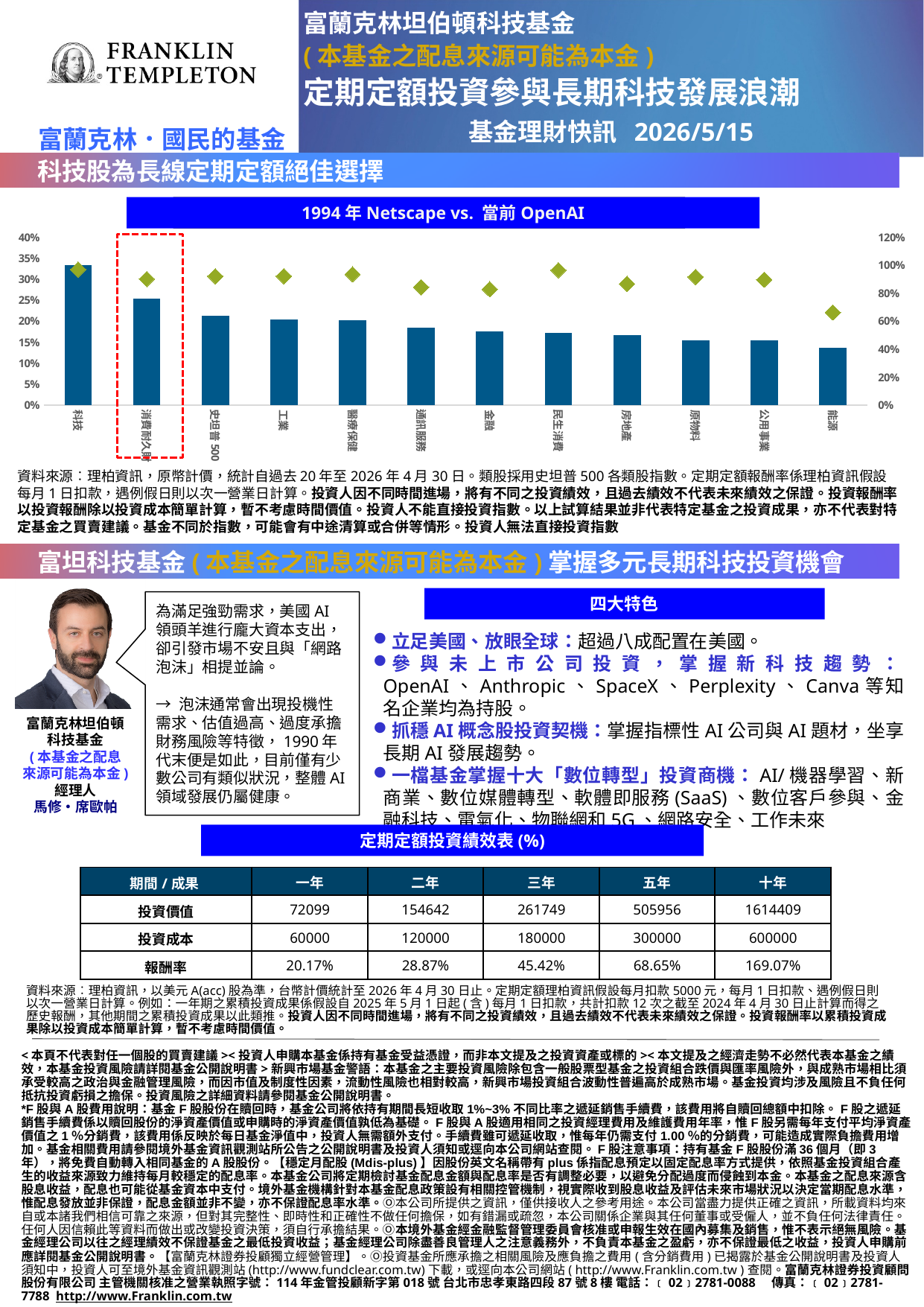
In the '1994 年 Netscape vs. 當前 OpenAI' chart, do the bar heights generally rise or fall from left to right? fall In the '1994 年 Netscape vs. 當前 OpenAI' chart, is the bar for 消費耐久財 greater or less than 20% on the left axis? greater Which category on the '1994 年 Netscape vs. 當前 OpenAI' chart is highlighted with a red dashed box? 消費耐久財 In the '1994 年 Netscape vs. 當前 OpenAI' chart, which category has the lowest diamond marker? 能源 In the '1994 年 Netscape vs. 當前 OpenAI' chart, which category has the tallest bar? 科技 What kind of chart is shown under the title '1994 年 Netscape vs. 當前 OpenAI'? combination bar and line chart (bars with diamond markers) In the '1994 年 Netscape vs. 當前 OpenAI' chart, which bar is taller: 科技 or 能源? 科技 In the '1994 年 Netscape vs. 當前 OpenAI' chart, is the diamond marker for 能源 greater or less than 80% on the right axis? less In the '1994 年 Netscape vs. 當前 OpenAI' chart, which category has the shortest bar? 能源 In the '1994 年 Netscape vs. 當前 OpenAI' chart, is the bar for 科技 greater or less than 30% on the left axis? greater How many categories are shown on the x axis of the '1994 年 Netscape vs. 當前 OpenAI' chart? 12